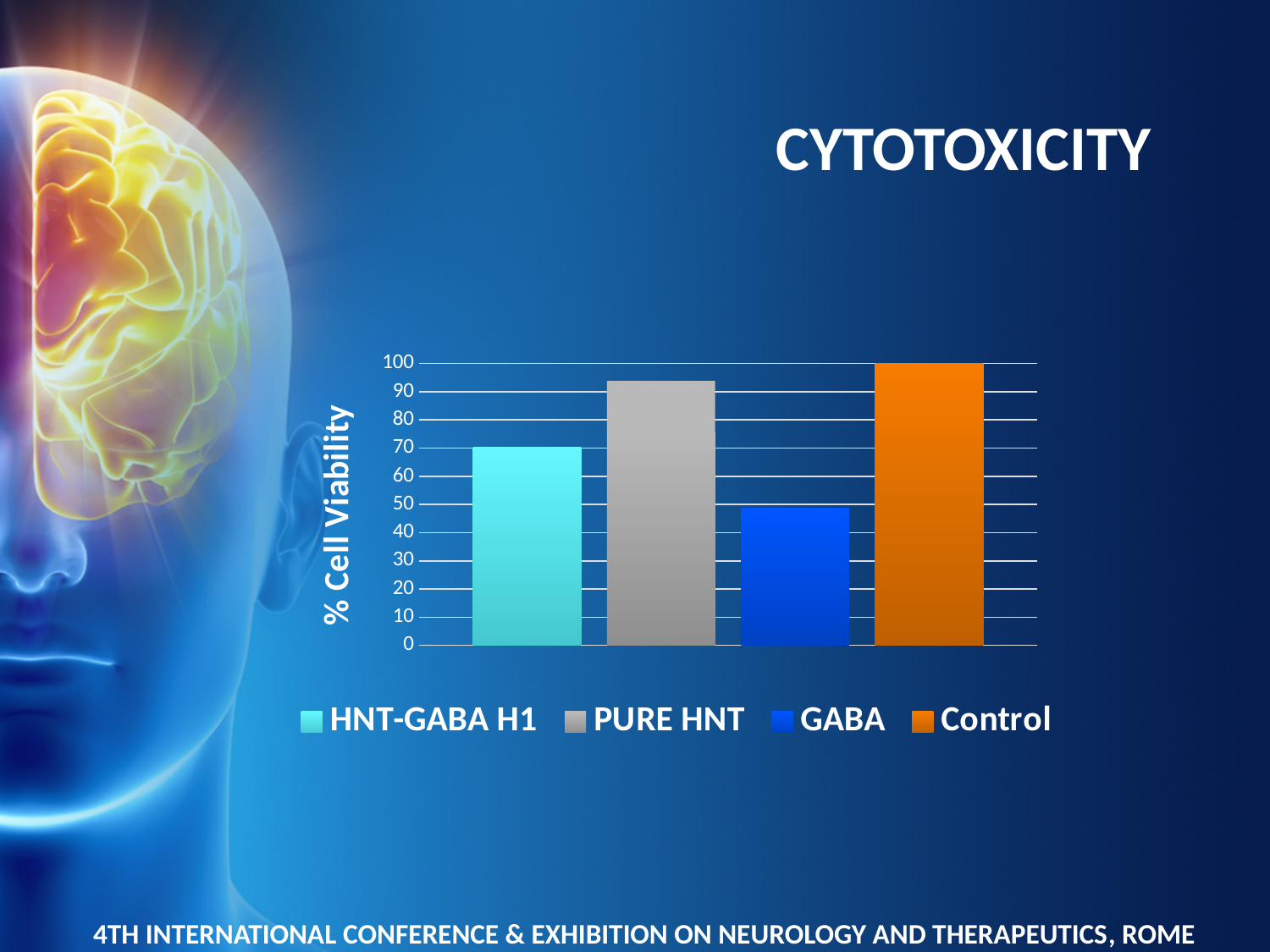
How many entries does the legend list? 4 Is the value for HNT-GABA H1 greater or less than 80? less Which has a higher % Cell Viability, PURE HNT or HNT-GABA H1? PURE HNT What is the title of the chart on the slide? CYTOTOXICITY What kind of chart is shown on the slide? bar chart What is the % Cell Viability value for Control? 100 Is the value for PURE HNT greater or less than 90? greater Which series has the highest % Cell Viability? Control How many bars are plotted in the chart? 4 What is the label on the vertical axis of the chart? % Cell Viability Which series has the lowest % Cell Viability? GABA Is the value for GABA greater or less than 60? less